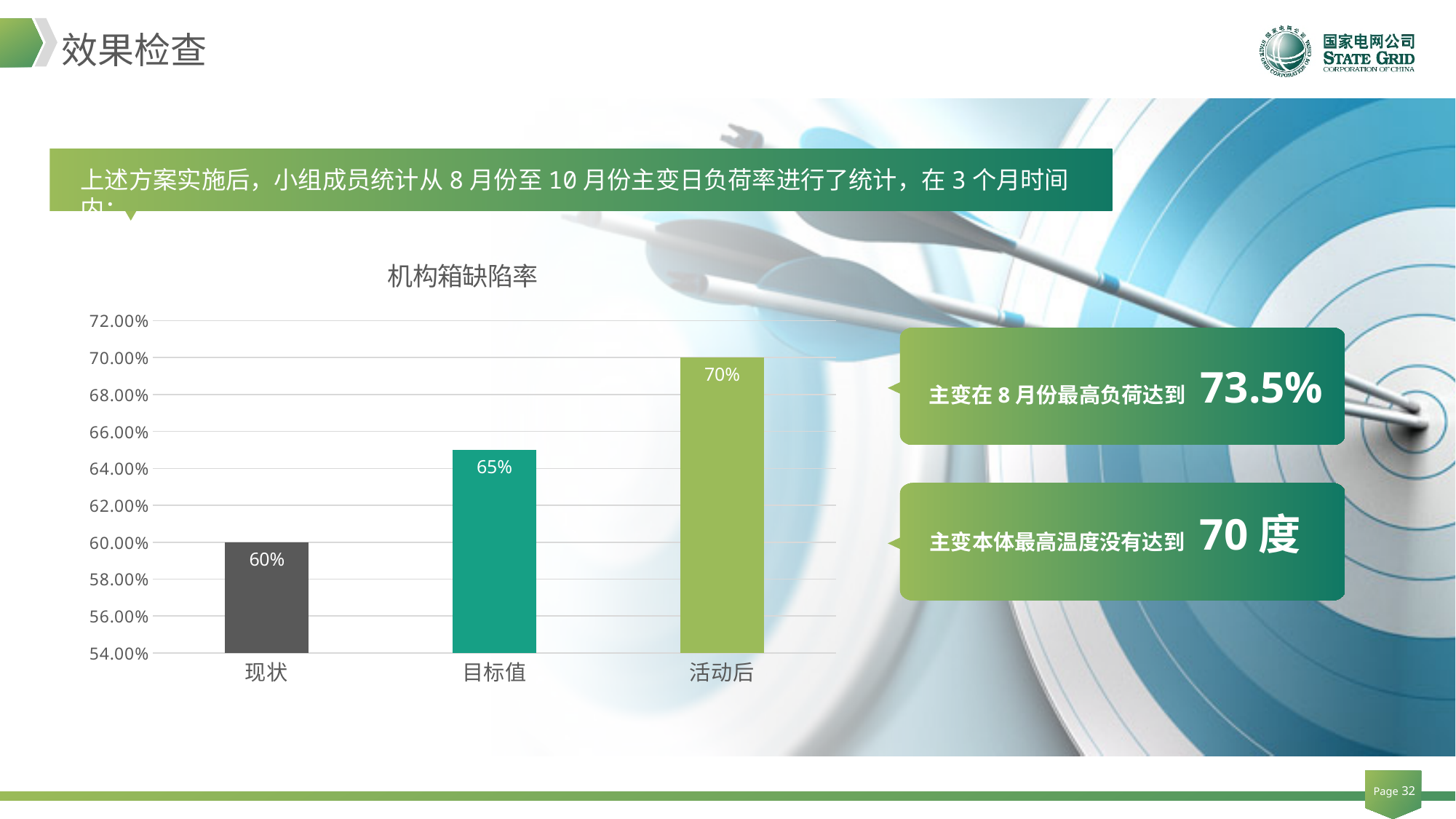
Which category has the lowest value? 现状 Do the values rise or fall from left to right along the x axis? rise What is the value for 目标值? 65% What colour is the bar for 目标值? teal green What type of chart is shown on the slide? bar chart Which is larger, the value for 目标值 or the value for 现状? 目标值 What is the value for 现状? 60% What is the title of the chart? 机构箱缺陷率 What is the difference between the values for 活动后 and 现状? 10% How many categories are shown on the x axis of the chart? 3 What is the value for 活动后? 70% Which category has the highest value? 活动后